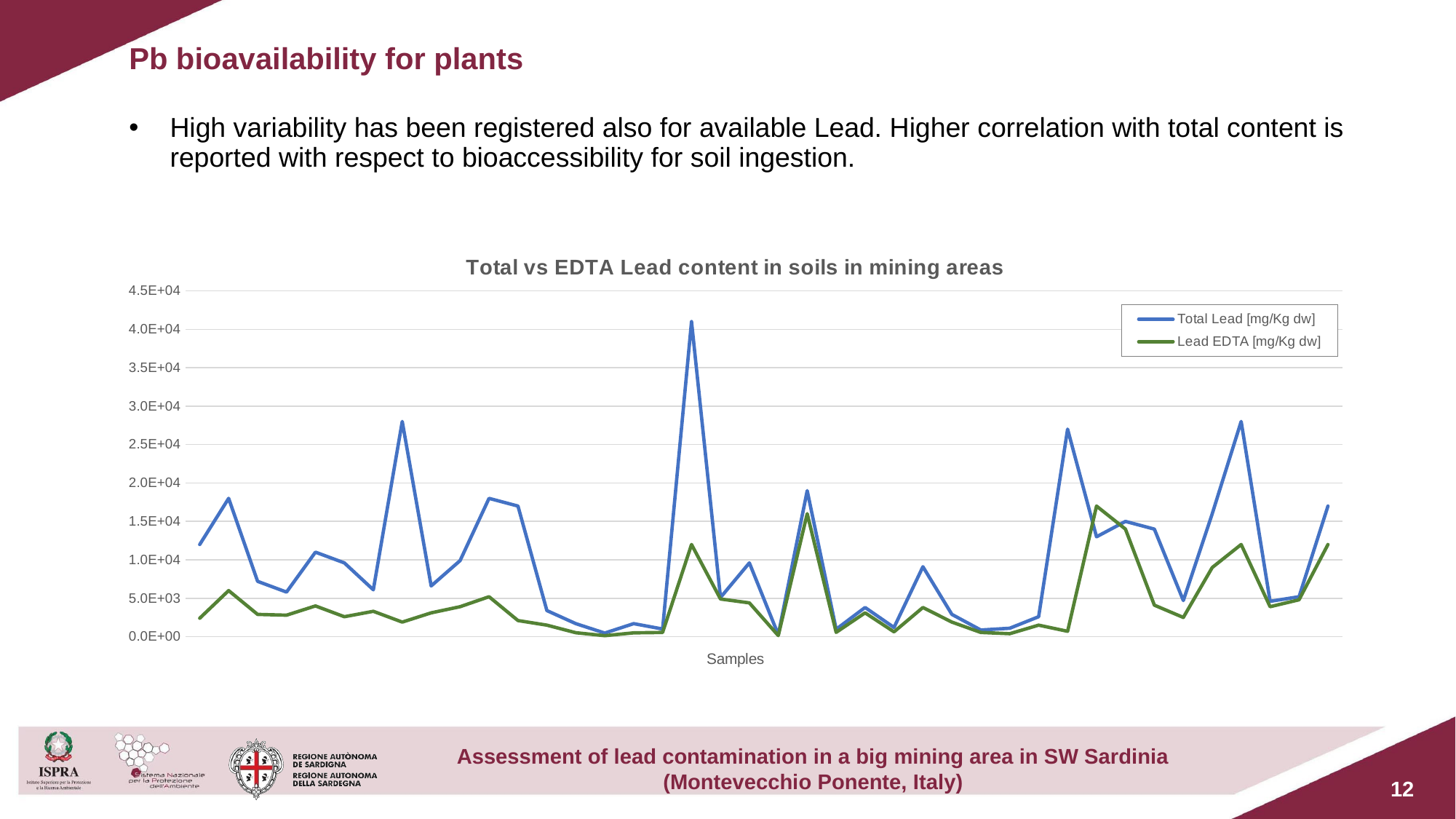
Is the highest value of the Lead EDTA [mg/Kg dw] series greater or less than 1.5E+04? greater Is the lowest value of the Total Lead [mg/Kg dw] series greater or less than 5.0E+03? less Is the highest value of the Total Lead [mg/Kg dw] series greater or less than 3.5E+04? greater What label is shown on the x axis of the chart? Samples How many series does the legend of the chart list? 2 What kind of chart is shown on the slide? Line chart Which series reaches the higher peak value, Total Lead [mg/Kg dw] or Lead EDTA [mg/Kg dw]? Total Lead [mg/Kg dw] What is the highest tick value shown on the y axis of the chart? 4.5E+04 What is the title of the chart? Total vs EDTA Lead content in soils in mining areas